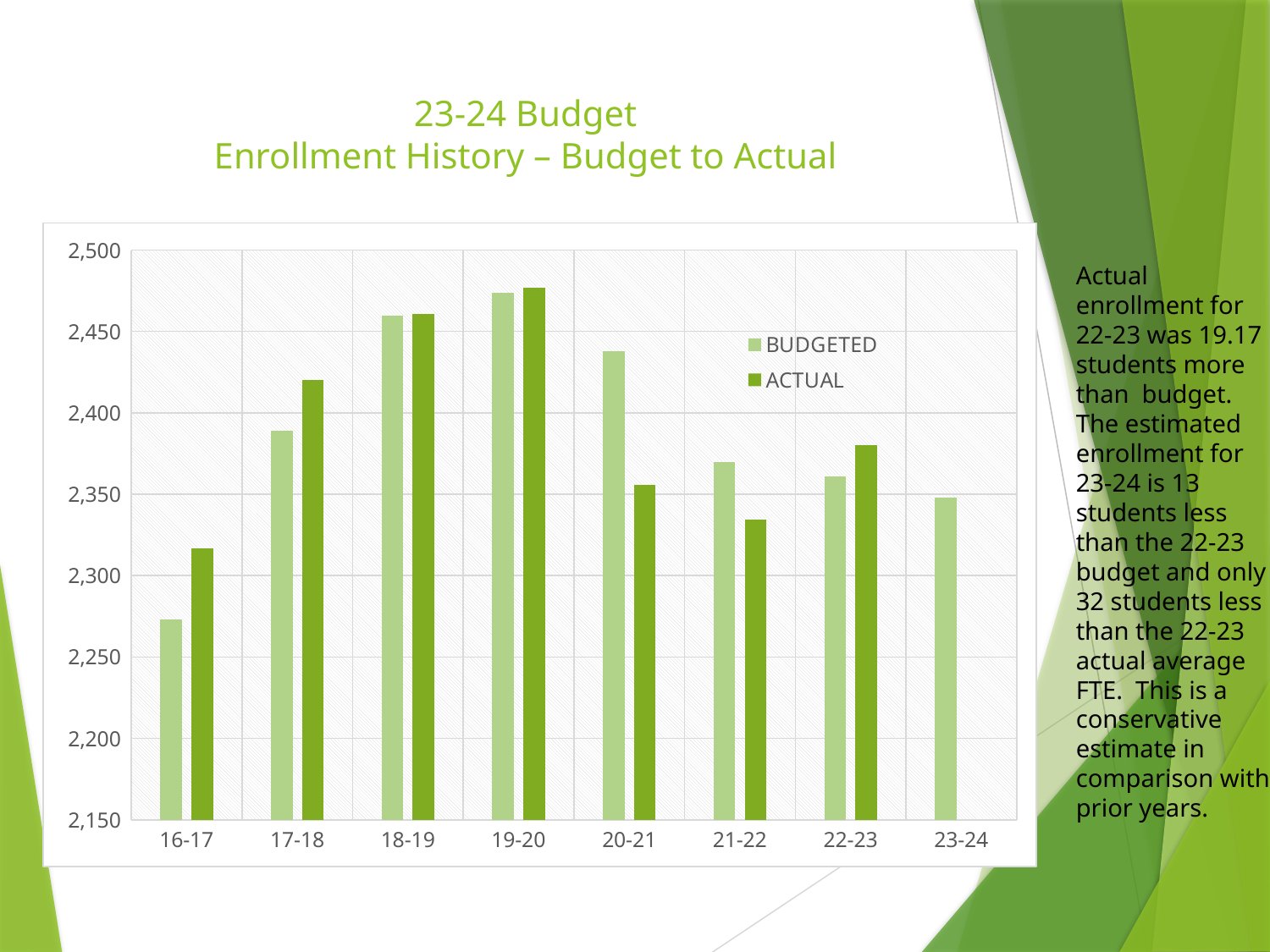
Do the ACTUAL values rise or fall from 19-20 to 21-22? Fall How many school-year categories are shown on the x axis? 8 Which year has the highest BUDGETED enrollment? 19-20 Is the BUDGETED value for 20-21 greater or less than 2,400? greater What kind of chart is shown on the slide? Bar chart Is the ACTUAL value for 21-22 greater or less than 2,350? less Which year has the lowest BUDGETED enrollment? 16-17 For 16-17, which is larger, the BUDGETED or the ACTUAL value? ACTUAL For 20-21, which is larger, the BUDGETED or the ACTUAL value? BUDGETED Which year has the lowest ACTUAL enrollment? 16-17 How many series does the legend list? 2 Is the BUDGETED value for 16-17 greater or less than 2,300? less